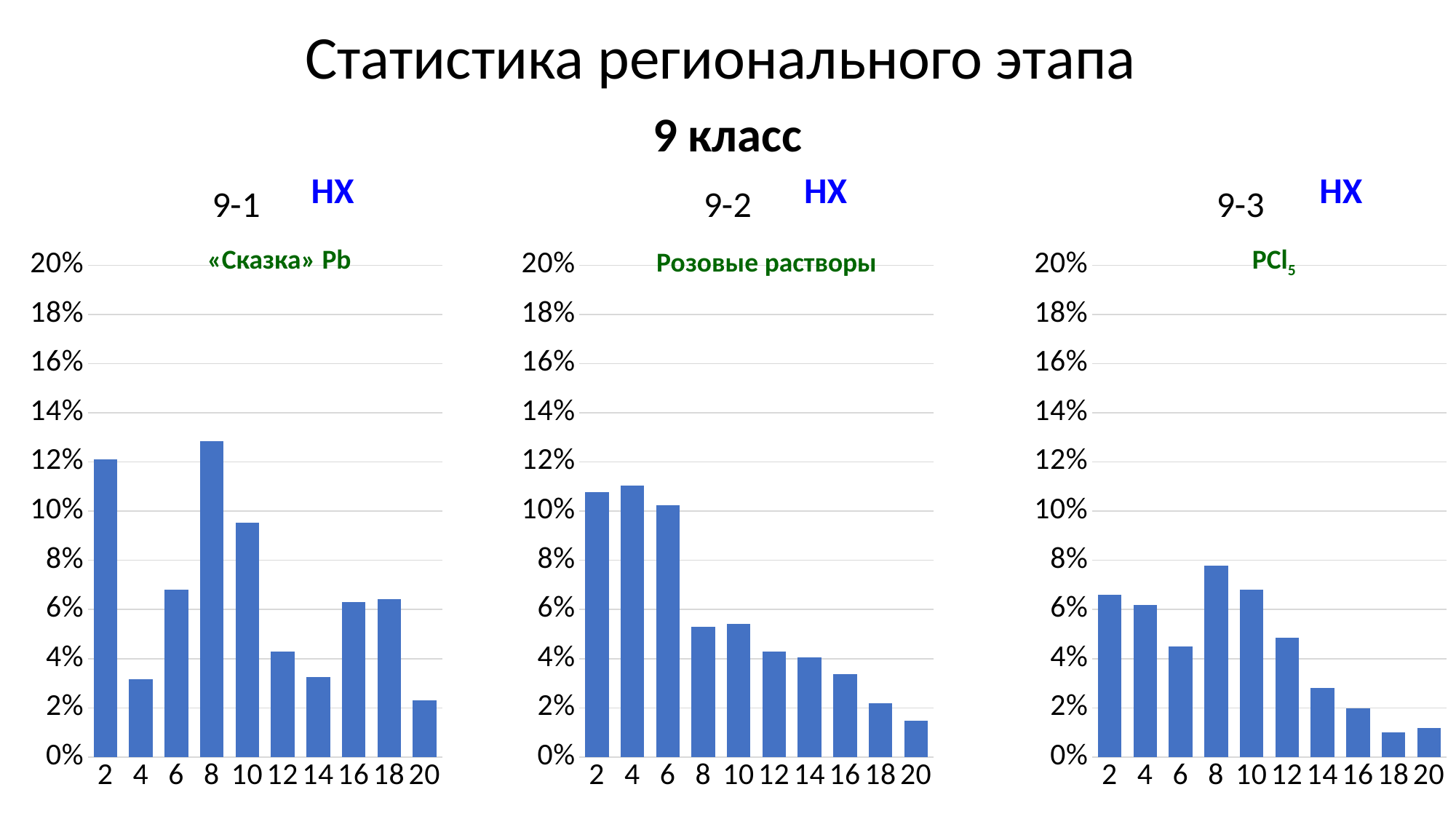
What is the highest value shown on the vertical axis of the 9-1 chart? 20% In the 9-2 chart, how many bars are plotted? 10 In the 9-1 chart, which category has the highest bar? 8 In the 9-3 chart, is the value for 14 greater or less than 4%? less In the 9-3 chart, which category has the highest bar? 8 In the 9-3 chart, which is larger, the value for 6 or the value for 8? 8 In the 9-1 chart, is the value for 2 greater or less than 10%? greater In the 9-2 chart, do the values generally rise or fall from category 2 to category 20? fall What kind of chart is the 9-1 chart? bar chart In the 9-2 chart, is the value for 8 greater or less than 6%? less In the 9-1 chart, which is larger, the value for 10 or the value for 12? 10 In the 9-2 chart, which category has the lowest bar? 20